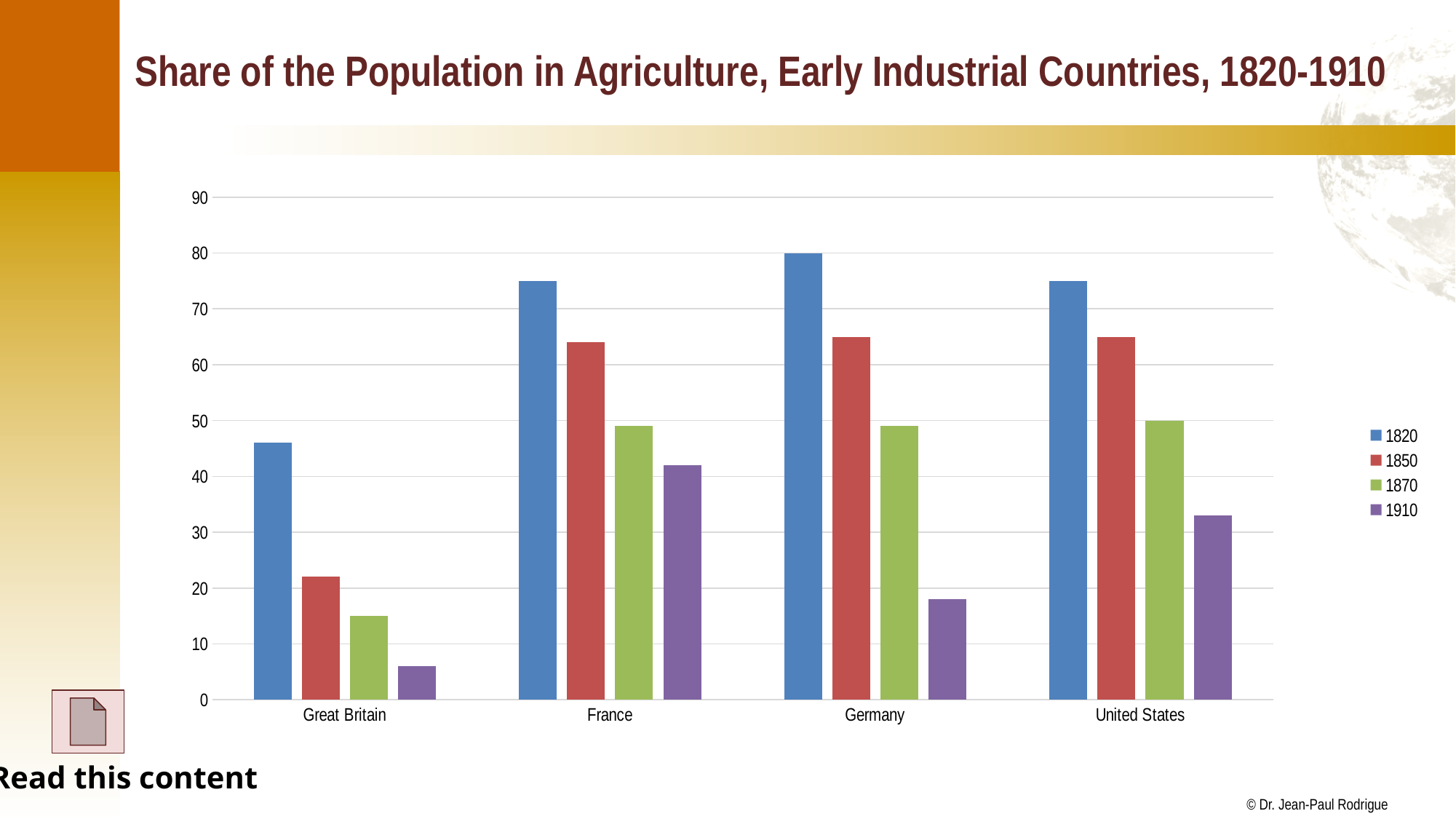
For each country, do the values rise or fall from 1820 to 1910? fall Which country has the highest value for 1820? Germany Is the value for Great Britain in 1850 greater or less than 30? less What is the value for the United States in 1870? 50 Which years are listed in the legend? 1820, 1850, 1870, 1910 How many countries are shown on the x axis? 4 Which is larger, the 1910 value for the United States or the 1910 value for Germany? United States What kind of chart is shown on the slide? bar chart Which country has the lowest value for 1910? Great Britain How many series does the legend list? 4 What is the value for Germany in 1820? 80 Is the value for France in 1910 greater or less than 40? greater